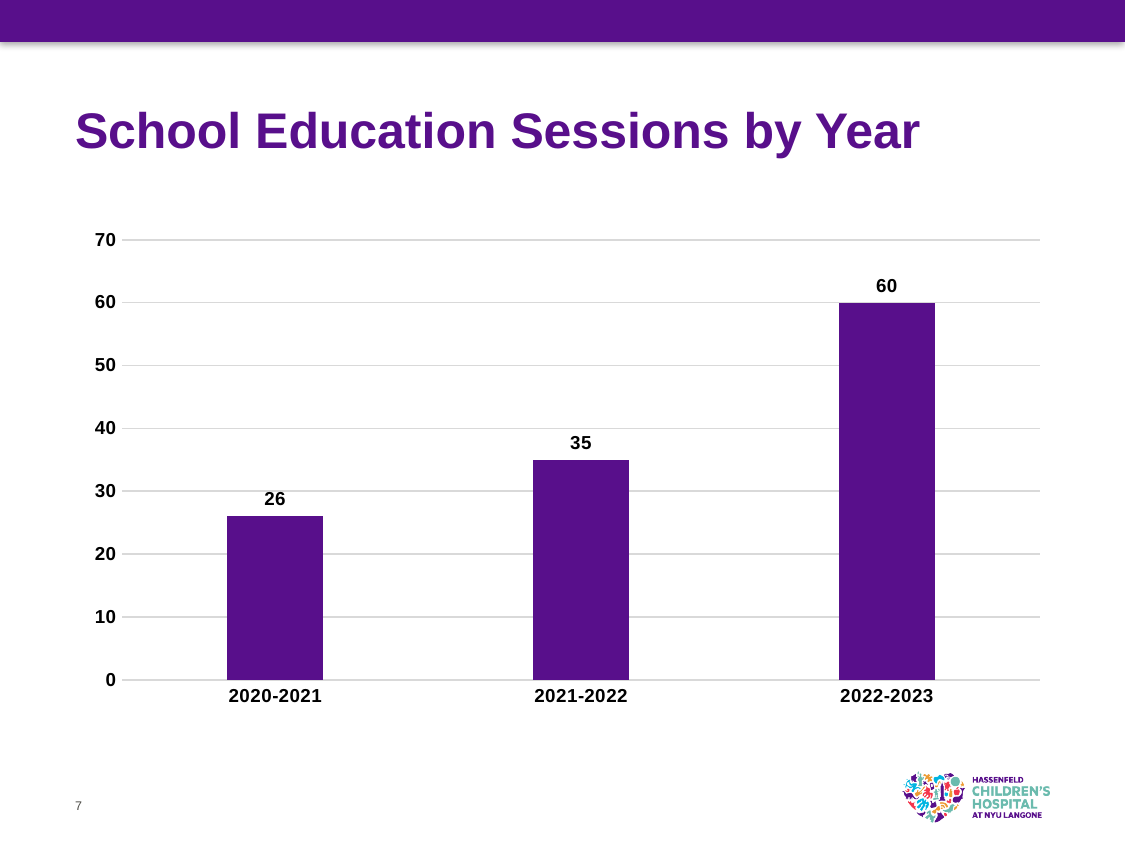
Is the value for 2022-2023 greater or less than 50? greater Do the values rise or fall from 2020-2021 to 2022-2023? rise What is the value for 2022-2023? 60 How many years are shown on the chart? 3 What is the value for 2020-2021? 26 What is the value for 2021-2022? 35 What is the difference between the values for 2021-2022 and 2020-2021? 9 Which is larger, the value for 2020-2021 or the value for 2021-2022? 2021-2022 Which year has the highest number of school education sessions? 2022-2023 What is the difference between the values for 2022-2023 and 2021-2022? 25 Which year has the lowest number of school education sessions? 2020-2021 What kind of chart is shown on the slide? bar chart